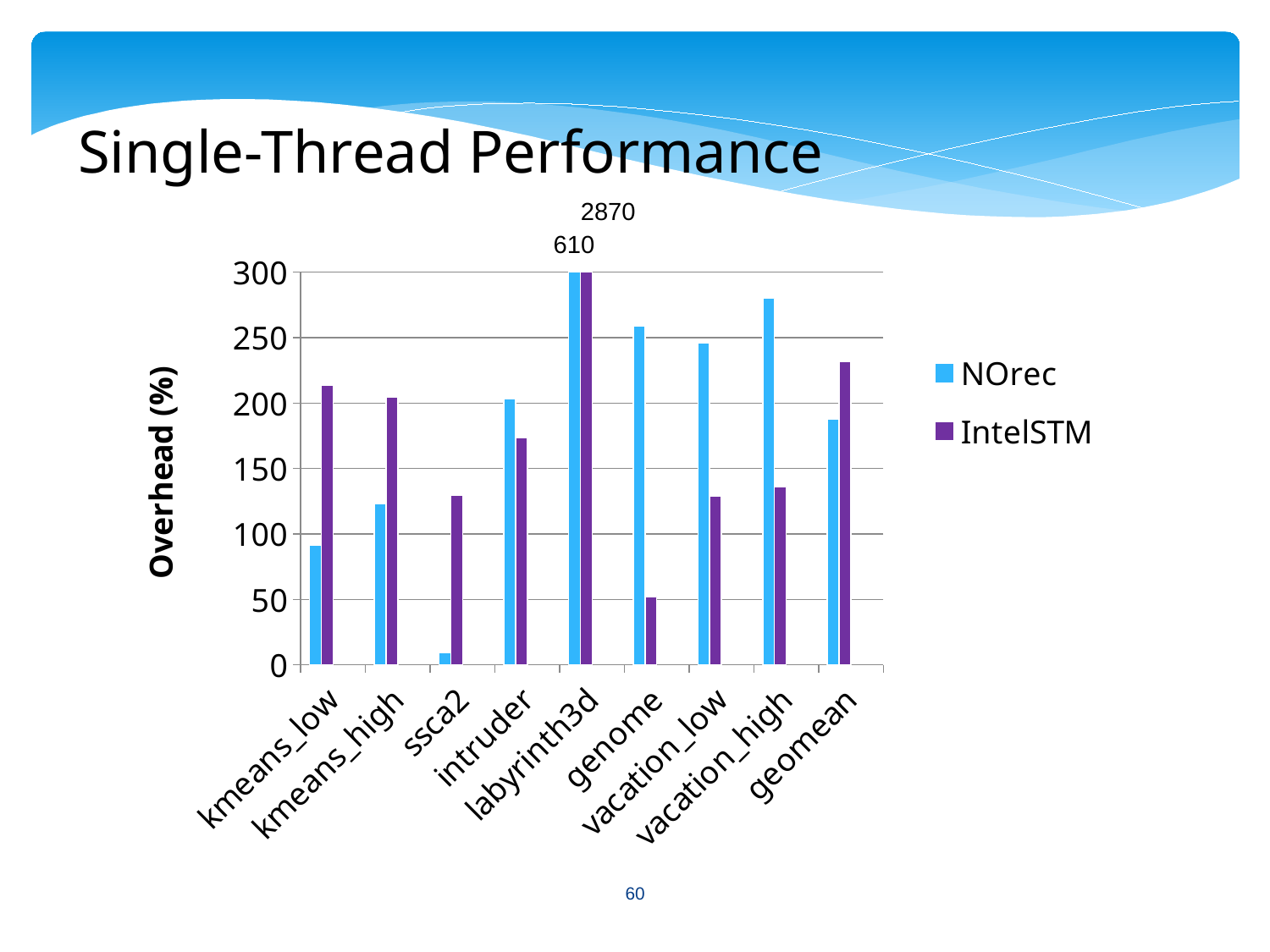
For geomean, which series has the larger overhead, NOrec or IntelSTM? IntelSTM Is the NOrec value for kmeans_low greater or less than 100? less For which category are both the NOrec and IntelSTM bars the highest? labyrinth3d Is the IntelSTM value for kmeans_low greater or less than 200? greater How many benchmark categories are shown on the x axis? 9 For genome, which series has the larger overhead, NOrec or IntelSTM? NOrec What is the title of the chart's y axis? Overhead (%) Which two values are printed above the labyrinth3d bars? 610 and 2870 How many series does the legend list? 2 For which category is the NOrec bar the lowest? ssca2 What kind of chart is shown on the slide? bar chart Is the NOrec value for vacation_high greater or less than 250? greater